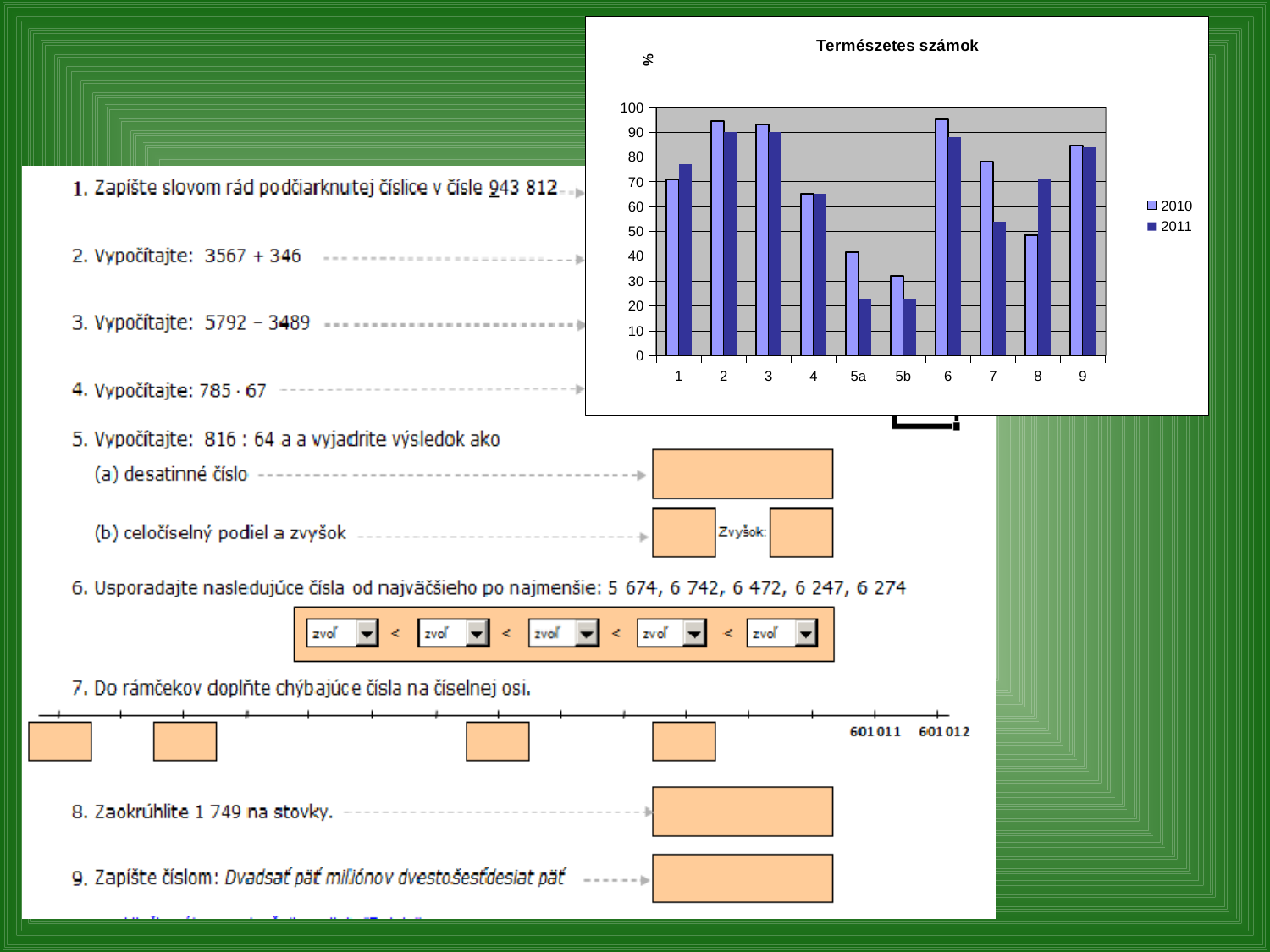
What unit label is shown on the vertical axis of the chart? % Is the 2011 value for category 8 greater or less than 60? greater For category 5a, which series has the larger value, 2010 or 2011? 2010 Which category has the lowest value for the 2010 series? 5b For category 7, which series has the larger value, 2010 or 2011? 2010 How many series does the chart legend list? 2 How many categories are shown on the x axis of the chart? 10 Is the 2010 value for category 5b greater or less than 40? less For category 8, which series has the larger value, 2010 or 2011? 2011 What is the title of the chart? Természetes számok What kind of chart is shown on the slide? bar chart Is the 2010 value for category 6 greater or less than 90? greater